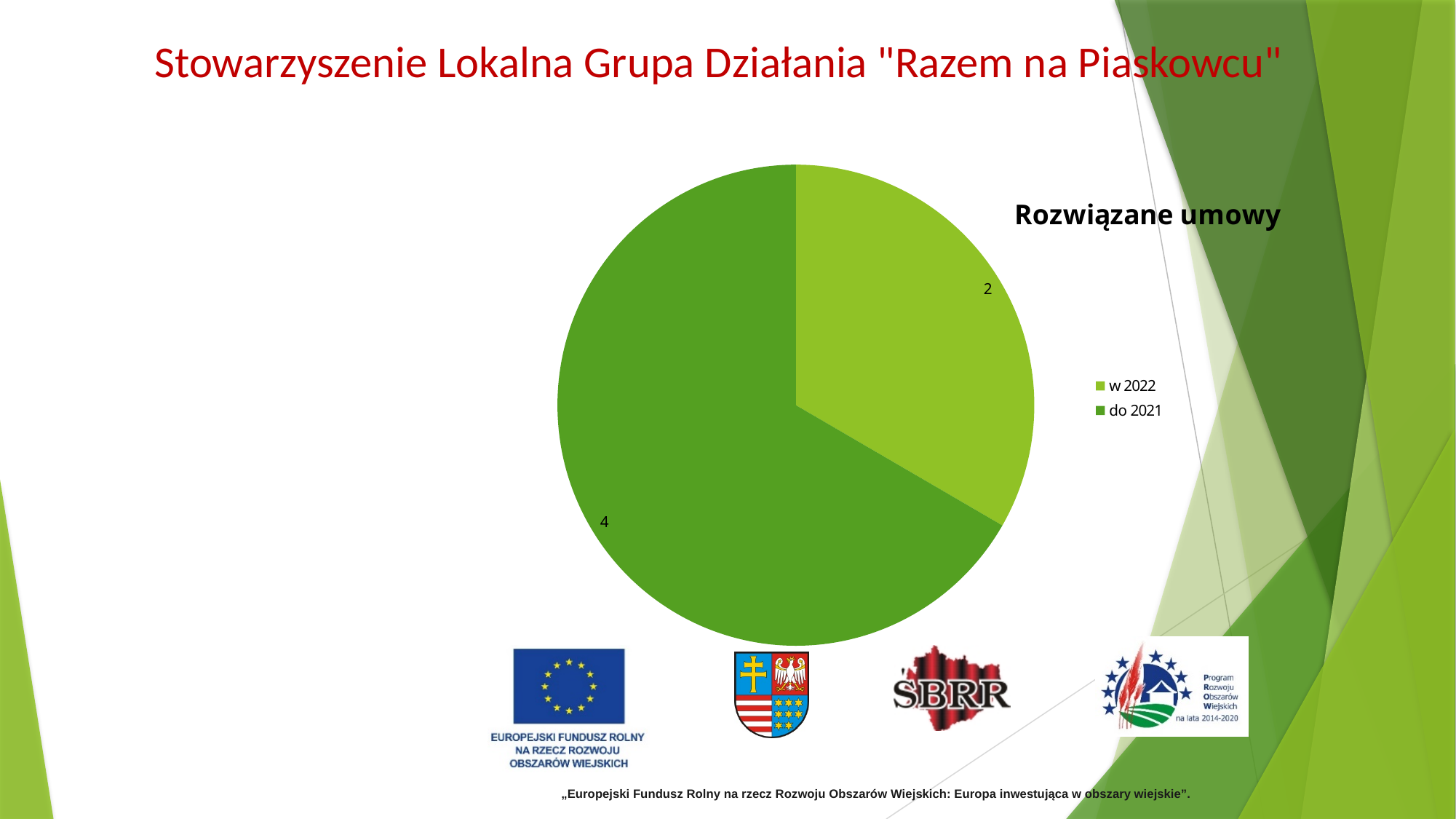
What is the value for "do 2021"? 4 Which category has the largest slice? do 2021 What kind of chart is shown on the slide? pie chart Which is larger, the value for "w 2022" or the value for "do 2021"? do 2021 What share of the pie does "do 2021" represent? 2/3 What is the title of the chart? Rozwiązane umowy What is the value for "w 2022"? 2 What is the difference between the values for "do 2021" and "w 2022"? 2 What is the total of all slices in the pie chart? 6 How many slices does the pie chart have? 2 How many entries does the legend list? 2 Which category has the smallest slice? w 2022